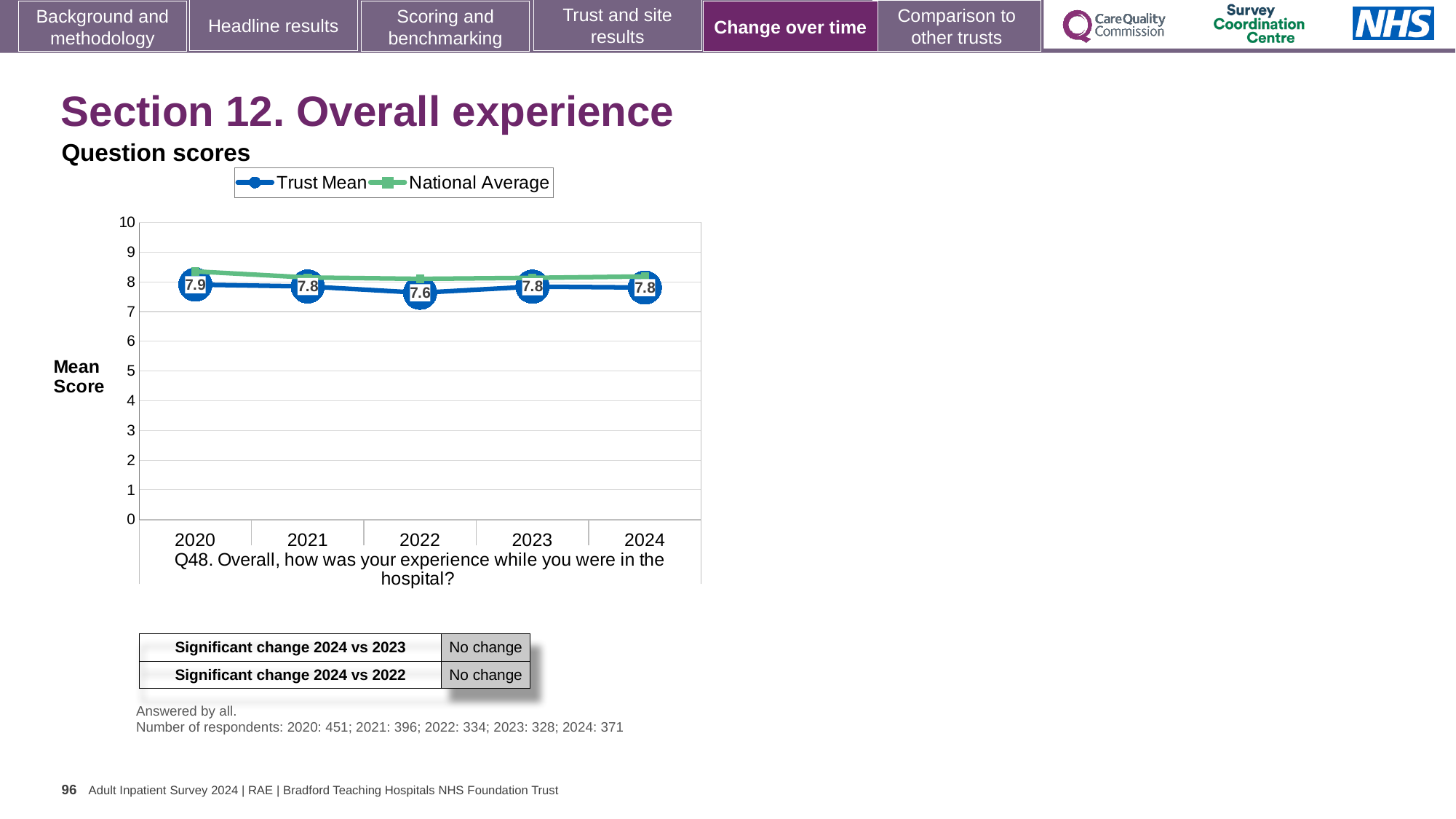
How many years are plotted on the x axis? 5 What is the Trust Mean value for 2024? 7.8 Is the National Average value for 2020 greater or less than 8? greater What is the difference between the Trust Mean in 2020 and in 2022? 0.3 In which year is the Trust Mean lowest? 2022 Does the Trust Mean rise or fall from 2020 to 2022? Fall What is the Trust Mean value for 2022? 7.6 What kind of chart is shown on the slide? Line chart How many series does the legend list? 2 What is the Trust Mean value for 2020? 7.9 In which year is the Trust Mean highest? 2020 Which is larger, the Trust Mean for 2021 or for 2022? 2021